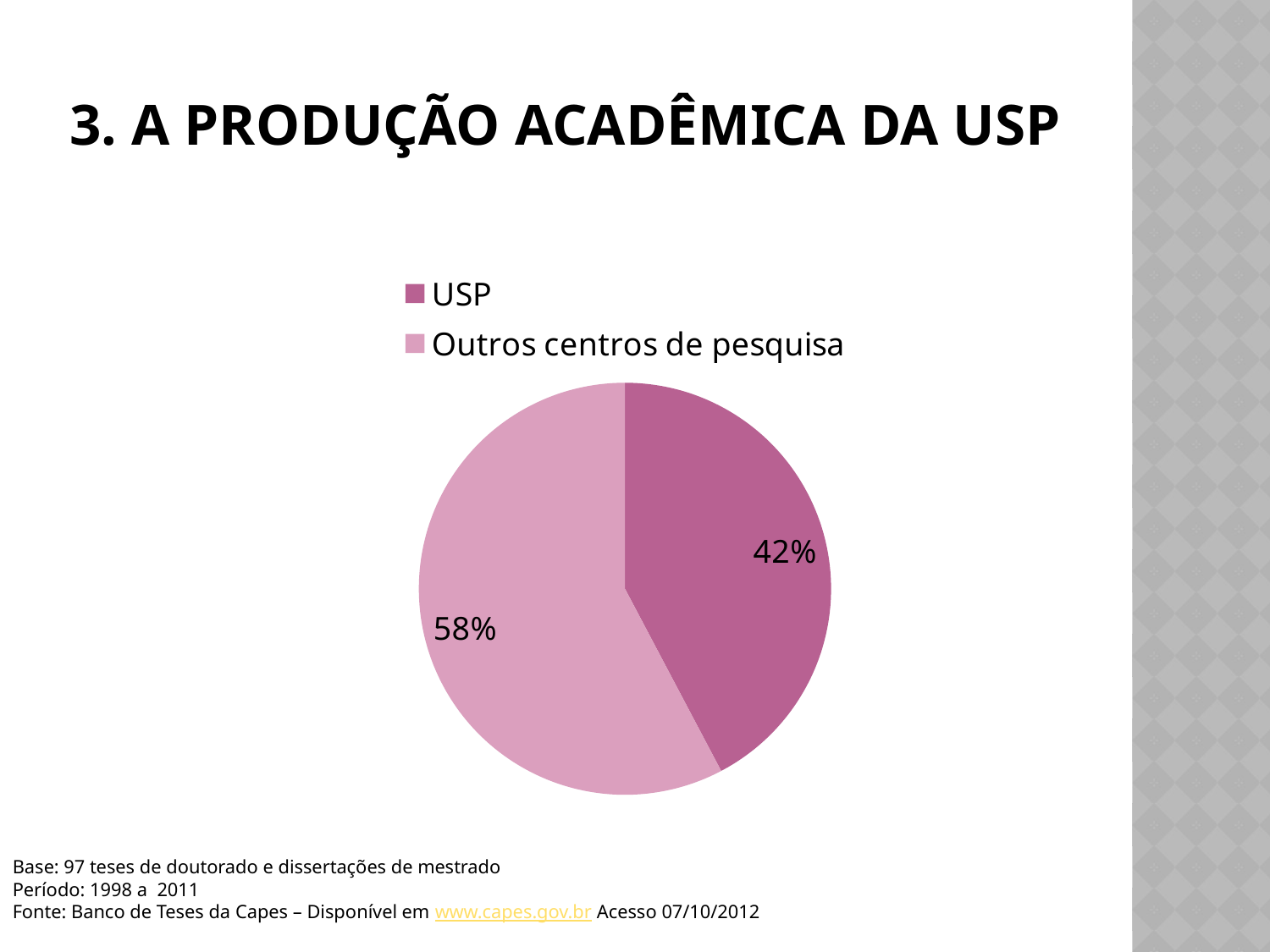
How many slices does the pie chart have? 2 Is the share for USP greater or less than 50%? less What share of the pie does USP account for? 42% What kind of chart is shown on the slide? pie chart Which slice of the pie is the smallest? USP How many entries does the legend list? 2 Which is larger, the USP slice or the Outros centros de pesquisa slice? Outros centros de pesquisa Which slice of the pie is the largest? Outros centros de pesquisa What is the difference in percentage points between the Outros centros de pesquisa slice and the USP slice? 16 What share of the pie does Outros centros de pesquisa account for? 58% What is the title of the slide containing the pie chart? 3. A PRODUÇÃO ACADÊMICA DA USP Which legend entry is shown in the darker pink colour? USP